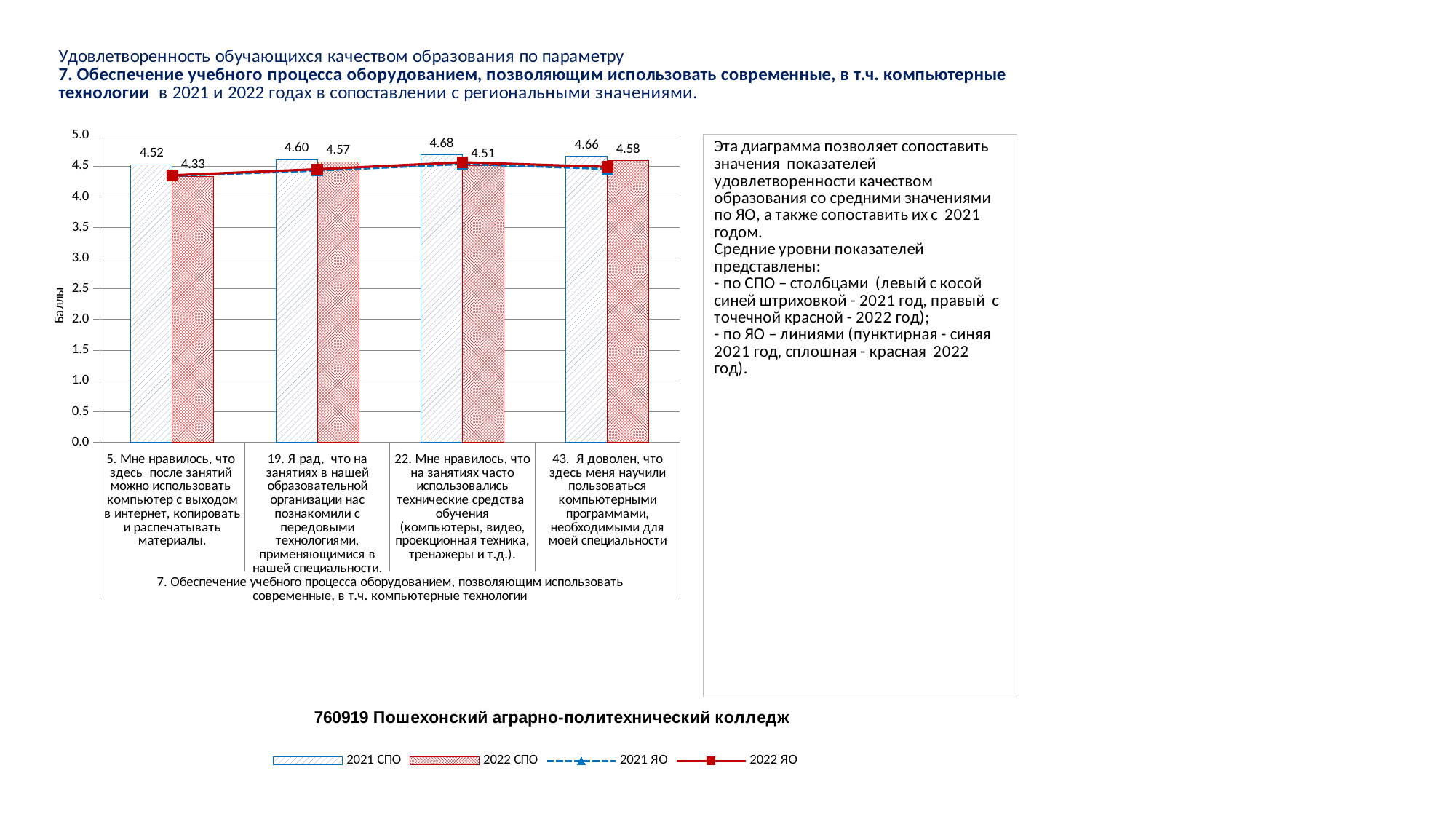
Which item has the lowest value in the 2022 СПО series? 5. Мне нравилось, что здесь после занятий можно использовать компьютер с выходом в интернет What is the value of the 2021 СПО series for item 22 ("Мне нравилось, что на занятиях часто использовались технические средства обучения...")? 4.68 Is the 2022 ЯО line value for item 5 greater or less than 4.0? greater What is the label of the vertical axis of the chart? Баллы What is the value of the 2021 СПО series for item 5 ("Мне нравилось, что здесь после занятий можно использовать компьютер с выходом в интернет...")? 4.52 How many series does the chart legend list? 4 What is the difference between the 2021 СПО and 2022 СПО values for item 5? 0.19 Which item has the highest value in the 2021 СПО series? 22. Мне нравилось, что на занятиях часто использовались технические средства обучения For item 19 ("Я рад, что на занятиях в нашей образовательной организации нас познакомили с передовыми технологиями..."), which is larger: the 2021 СПО value or the 2022 СПО value? 2021 СПО How many items (categories) are shown on the x axis of the chart? 4 What is the value of the 2022 СПО series for item 5 ("Мне нравилось, что здесь после занятий можно использовать компьютер...")? 4.33 What is the value of the 2022 СПО series for item 43 ("Я доволен, что здесь меня научили пользоваться компьютерными программами...")? 4.58